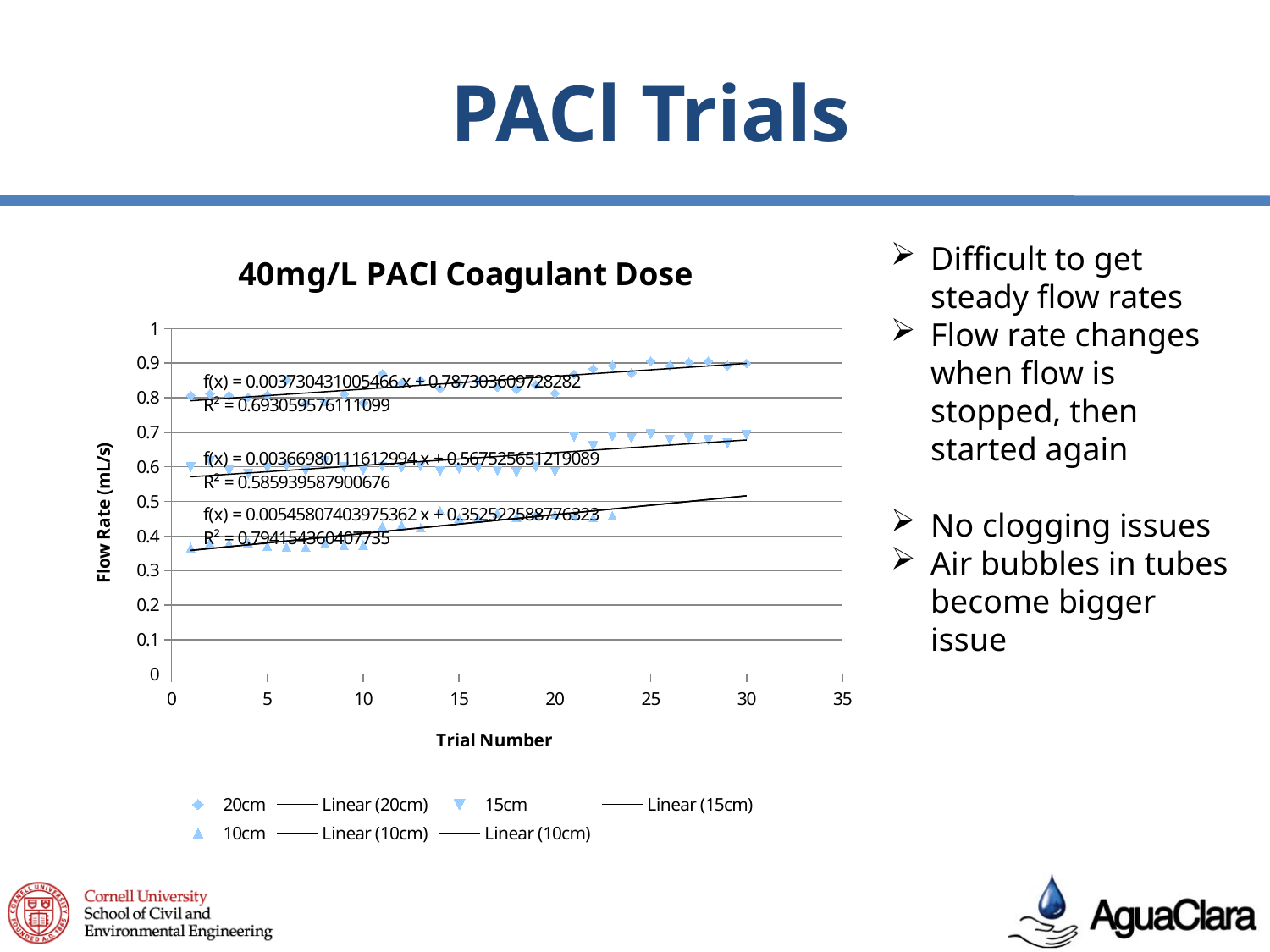
What type of chart is shown on the slide? scatter chart What is the label of the y axis? Flow Rate (mL/s) Is the flow rate for the 15cm series at trial 25 greater or less than 0.5? greater Is the flow rate for the 20cm series at trial 30 greater or less than 0.7? greater Which series has the lowest flow rates overall? 10cm Which series has the highest flow rates overall? 20cm Do the flow rates for the 10cm series generally rise or fall as the trial number increases? rise What R² value is printed for the trendline of the 10cm series (the lowest trendline)? 0.794154360407735 Is the flow rate for the 10cm series at trial 5 greater or less than 0.5? less How many entries does the chart legend list? 7 What is the title of the chart? 40mg/L PACl Coagulant Dose